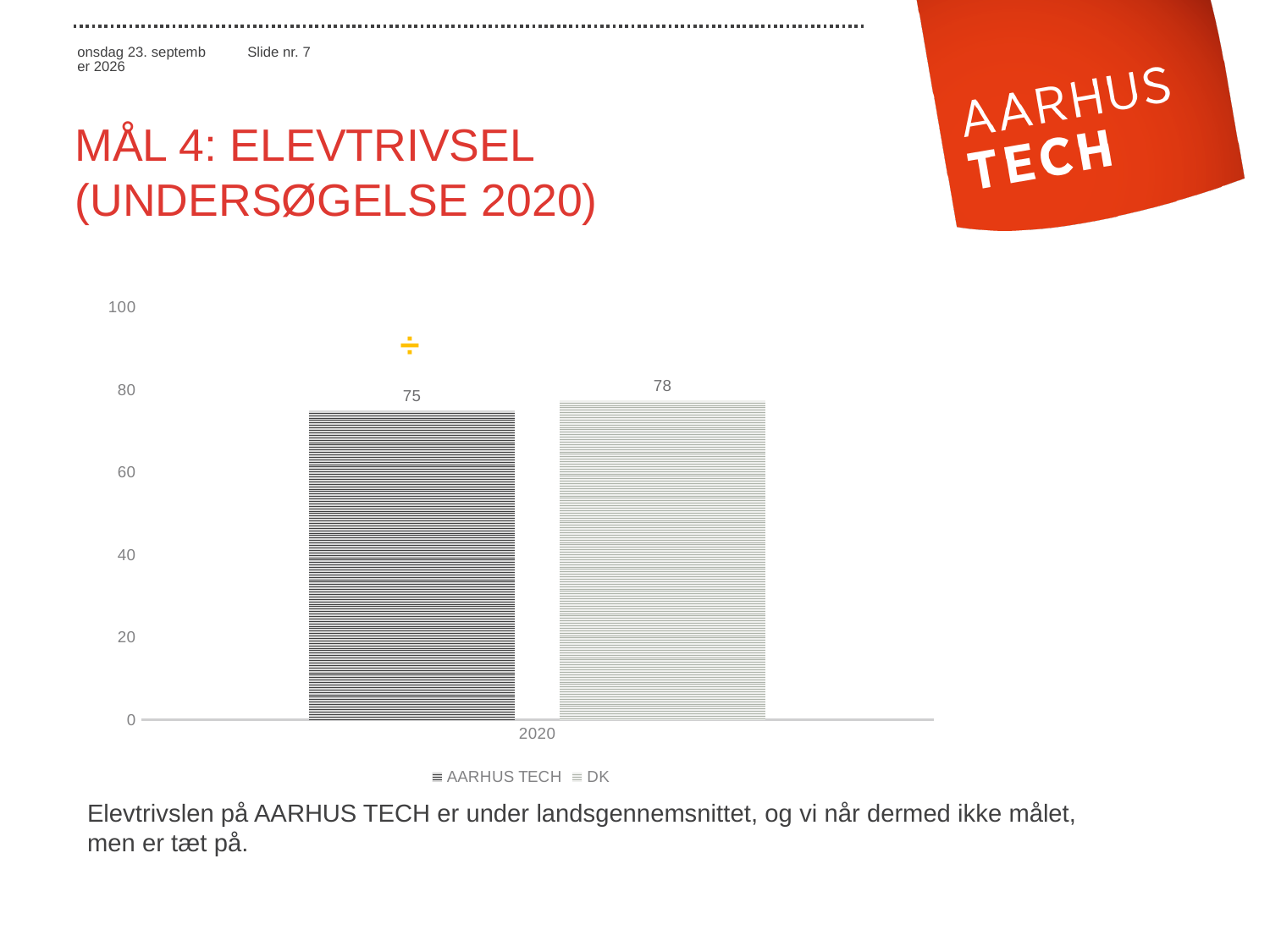
What are the two series named in the legend? AARHUS TECH and DK What is the value for AARHUS TECH in 2020? 75 What kind of chart is shown on the slide? bar chart How many series does the legend list? 2 Which series has the lowest value in the chart? AARHUS TECH What is the maximum value shown on the y axis? 100 Is the value for AARHUS TECH in 2020 greater or less than 80? less What is the value for DK in 2020? 78 What is the difference between the DK value and the AARHUS TECH value in 2020? 3 How many categories are shown on the x axis? 1 Is the value for DK in 2020 greater or less than 60? greater Which series has the higher value in 2020, AARHUS TECH or DK? DK